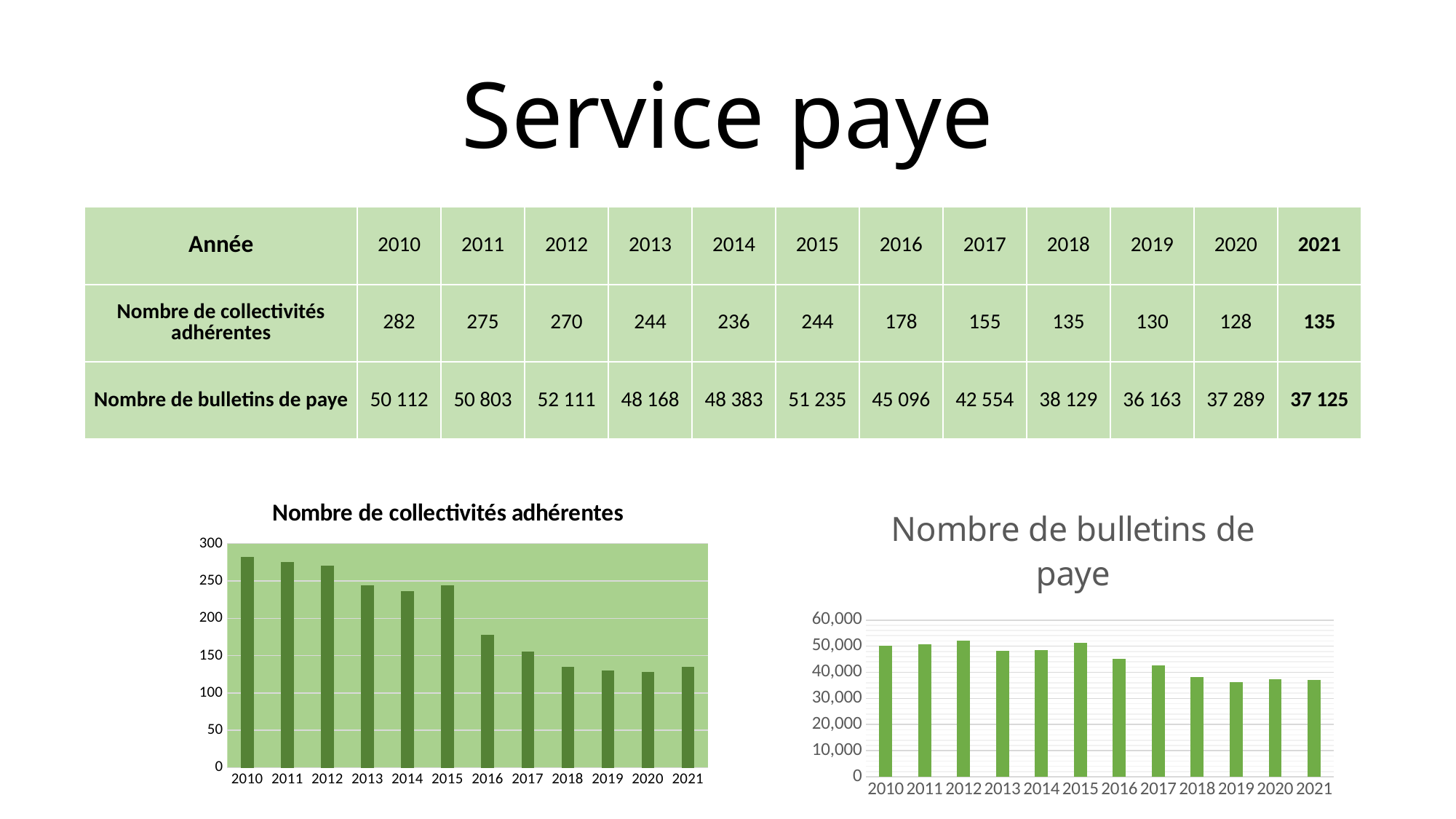
In the chart 'Nombre de collectivités adhérentes', what is the difference between the values for 2010 and 2021? 147 What kind of chart is 'Nombre de collectivités adhérentes'? bar chart How many years are shown on the x axis of the chart 'Nombre de bulletins de paye'? 12 In the chart 'Nombre de collectivités adhérentes', what is the value for 2010? 282 In the chart 'Nombre de collectivités adhérentes', which is larger, the value for 2013 or the value for 2016? 2013 In the chart 'Nombre de collectivités adhérentes', do the values generally rise or fall from 2010 to 2021? fall In the chart 'Nombre de bulletins de paye', what is the value for 2021? 37 125 In the chart 'Nombre de collectivités adhérentes', is the value for 2019 greater or less than 150? less In the chart 'Nombre de bulletins de paye', which year has the highest value? 2012 In the chart 'Nombre de collectivités adhérentes', which year has the highest value? 2010 In the chart 'Nombre de bulletins de paye', which year has the lowest value? 2019 In the chart 'Nombre de bulletins de paye', is the value for 2016 greater or less than 40,000? greater